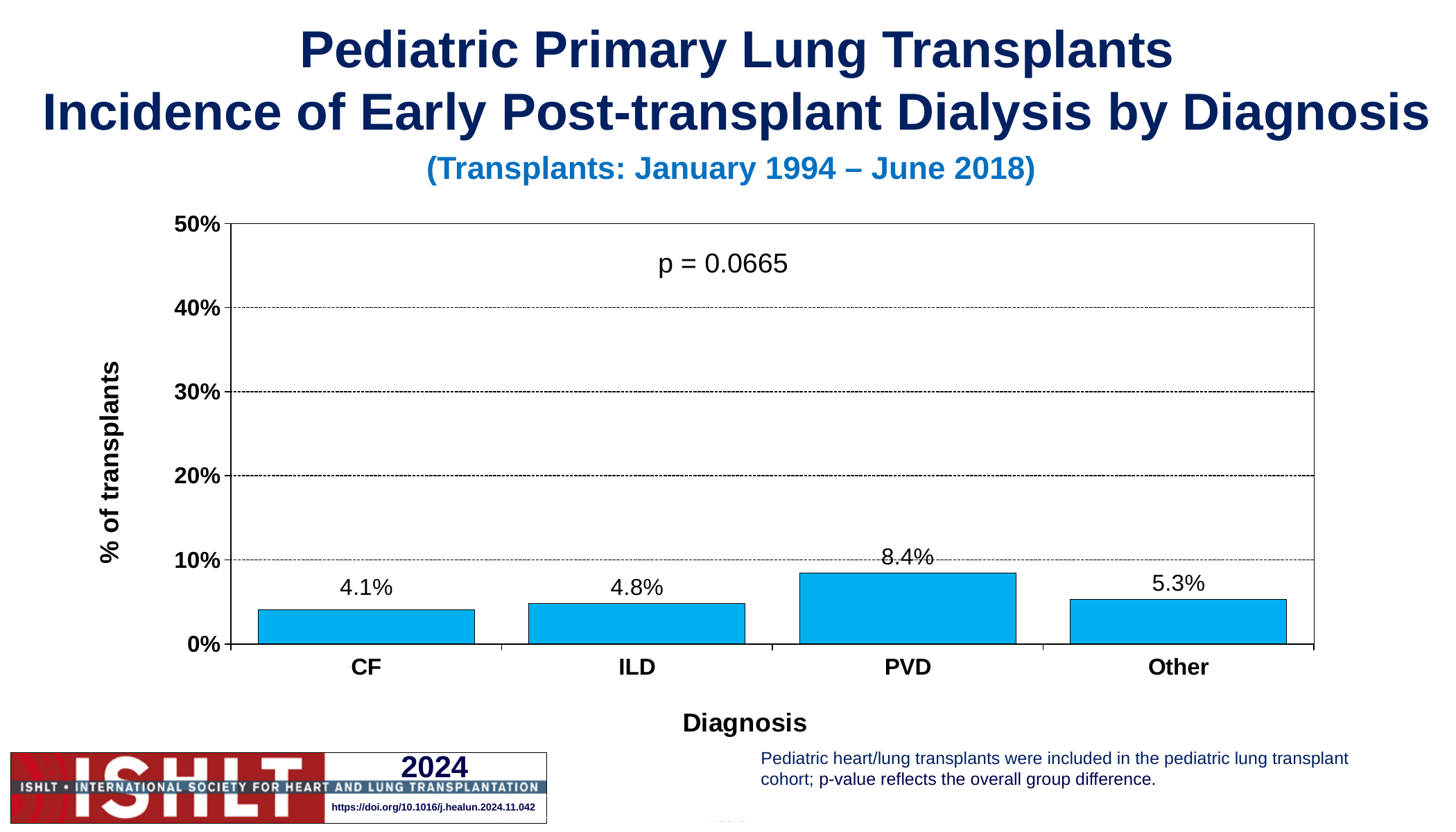
What is the value for PVD? 8.4% How many diagnosis categories are shown on the x axis? 4 What is the value for CF? 4.1% Which diagnosis has the lowest incidence of early post-transplant dialysis? CF What kind of chart is shown on the slide? Bar chart Which diagnosis has the highest incidence of early post-transplant dialysis? PVD Which is larger, the value for ILD or the value for Other? Other Is the value for PVD greater or less than 10%? less What p-value is printed on the chart? p = 0.0665 What is the difference between the values for PVD and CF? 4.3% What is the difference between the values for Other and ILD? 0.5% What is the value for Other? 5.3%